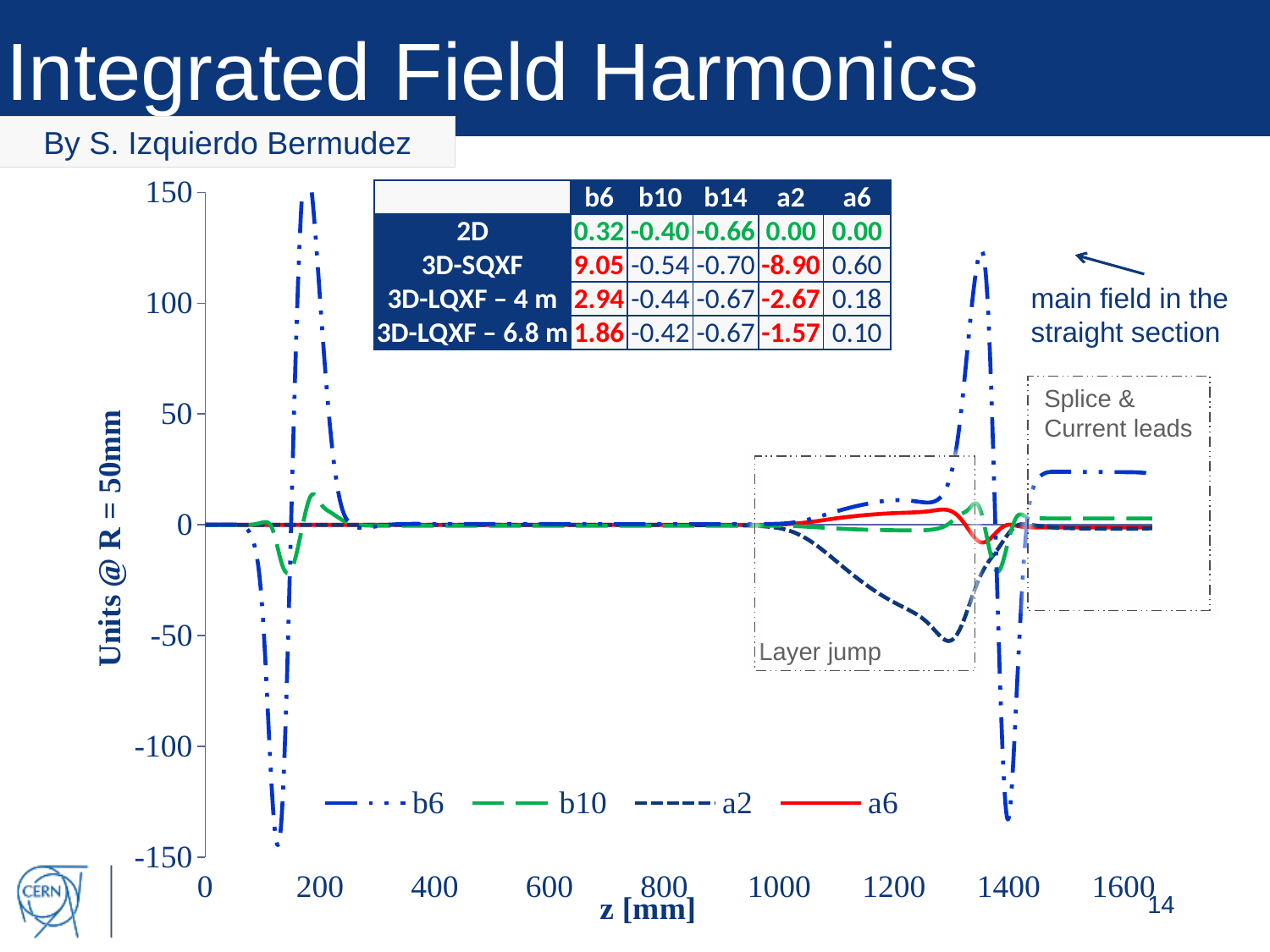
How many series does the chart legend list? 4 Is the value of a2 near z = 1300 mm greater or less than 0? less Which series reaches the lowest value on the chart? b6 Which series reaches the highest value on the chart? b6 What is the label of the x axis of the chart? z [mm] Is the peak value of b6 near z = 200 mm greater or less than 100? greater Near z = 1300 mm, which series has the larger value, a6 or a2? a6 Is the value of b6 near z = 1500 mm greater or less than 50? less Near z = 200 mm, which series has the larger value, b6 or b10? b6 What kind of chart is shown on the slide? line chart What is the label of the y axis of the chart? Units @ R = 50mm